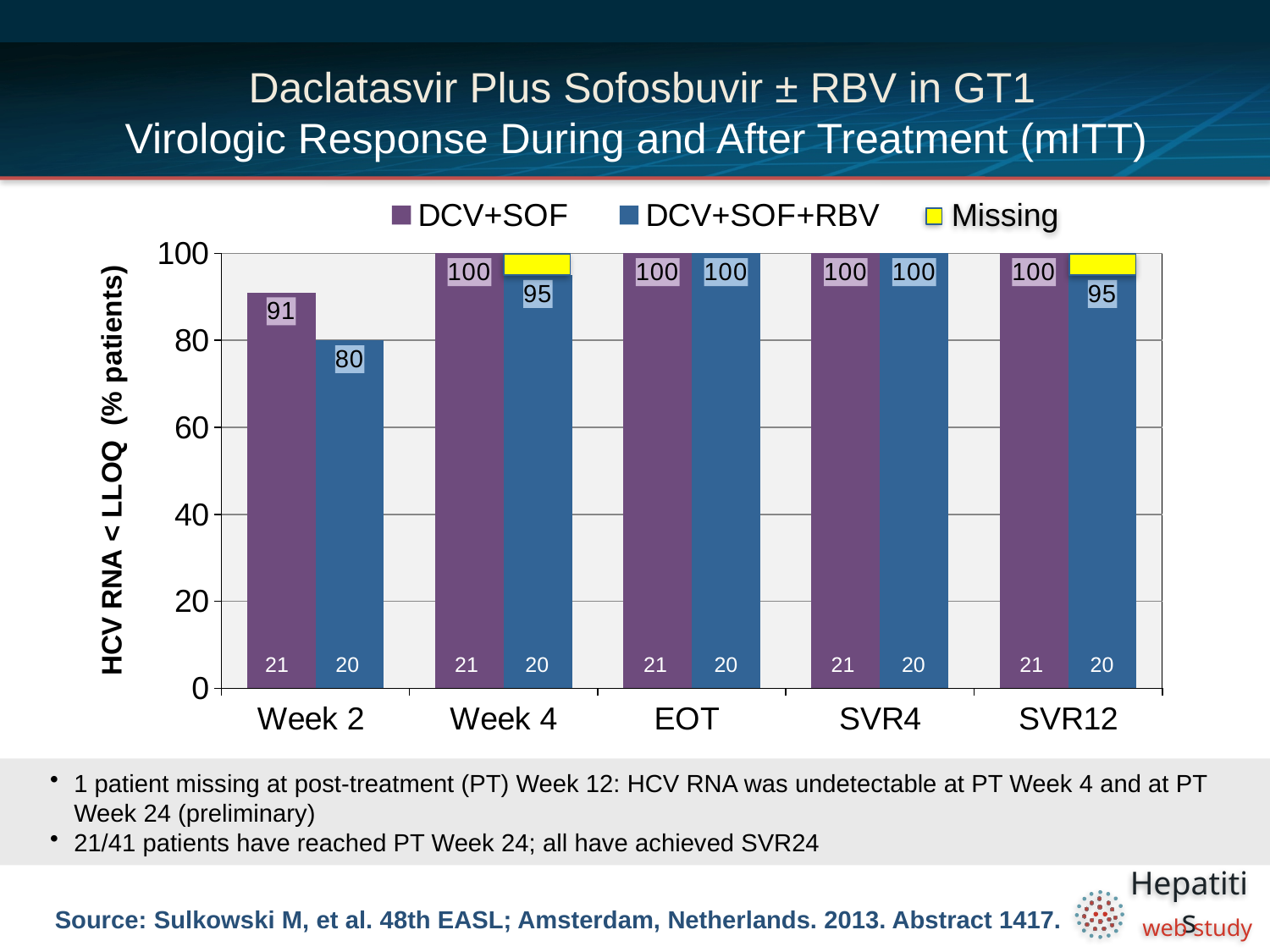
Which legend entry is shown in yellow? Missing What is the value for DCV+SOF+RBV at Week 2? 80 What kind of chart is shown on the slide? Bar chart At which time point is the DCV+SOF+RBV value lowest? Week 2 How many series does the legend list? 3 What is the value for DCV+SOF+RBV at SVR12? 95 What is the value for DCV+SOF at SVR4? 100 What is the value for DCV+SOF+RBV at Week 4? 95 How many time points are shown on the x axis? 5 What is the difference between the DCV+SOF and DCV+SOF+RBV values at Week 2? 11 What is the value for DCV+SOF at Week 2? 91 At Week 2, which arm has the higher value, DCV+SOF or DCV+SOF+RBV? DCV+SOF